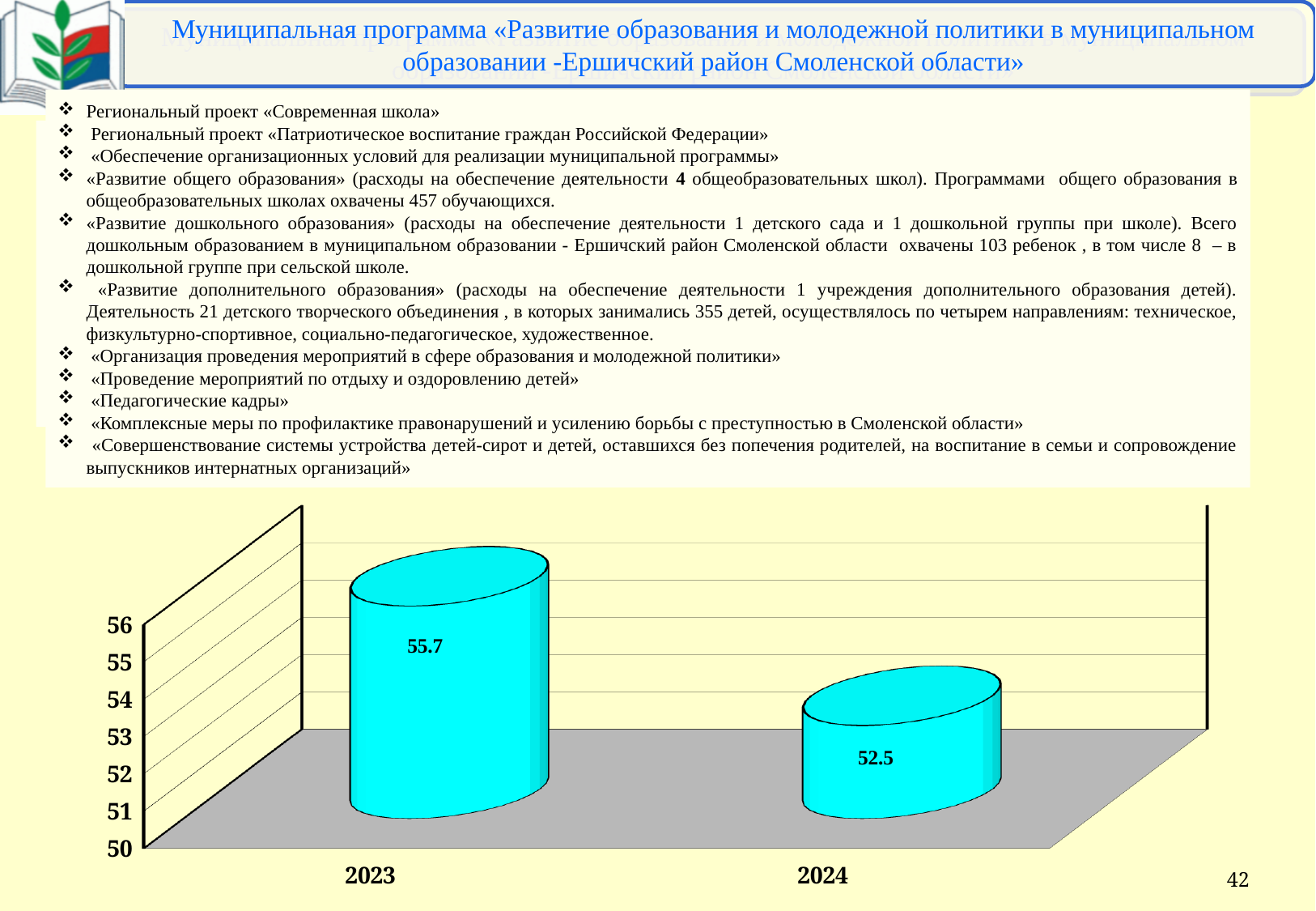
What is the lowest value shown on the chart's vertical axis? 50 Which is larger, the value for 2023 or the value for 2024? 2023 Which year has the highest value? 2023 What kind of chart is shown on the slide? bar chart Is the value for 2024 greater or less than 53? less Do the values rise or fall from 2023 to 2024? fall Is the value for 2023 greater or less than 55? greater What is the value for 2024? 52.5 What is the value for 2023? 55.7 How many categories are shown on the x axis of the chart? 2 Which year has the lowest value? 2024 What is the difference between the values for 2023 and 2024? 3.2